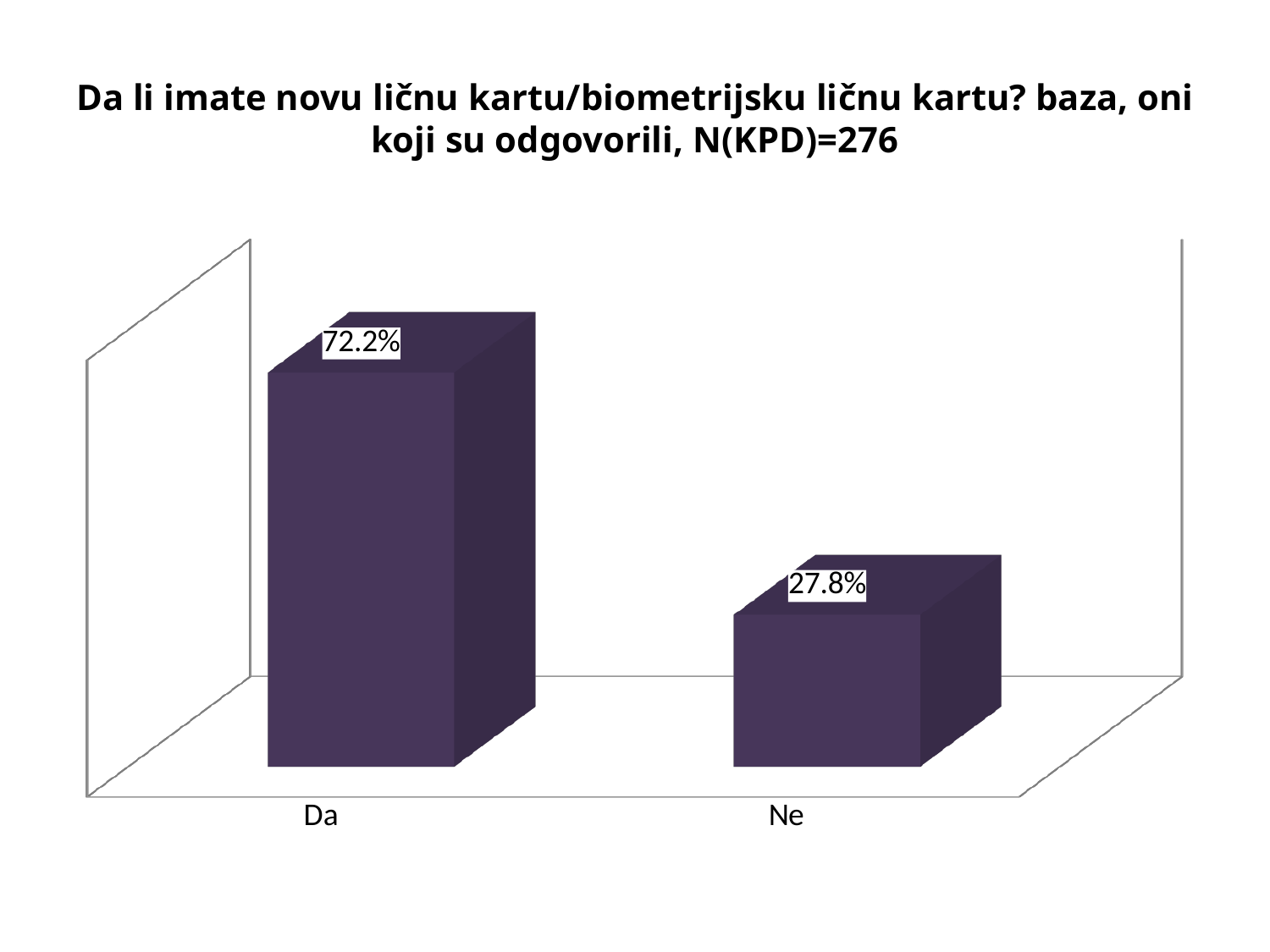
Which category has the lowest value? Ne What colour are the bars in the chart? Dark purple Which is larger, the value for "Da" or the value for "Ne"? Da How many categories are shown in the chart? 2 What is the total of the two values shown in the chart? 100% What is the sample size N(KPD) stated in the chart title? 276 What is the difference between the values for "Da" and "Ne"? 44.4% Which category has the highest value? Da What is the value for "Ne"? 27.8% What kind of chart is shown on the slide? Bar chart What is the value for "Da"? 72.2%